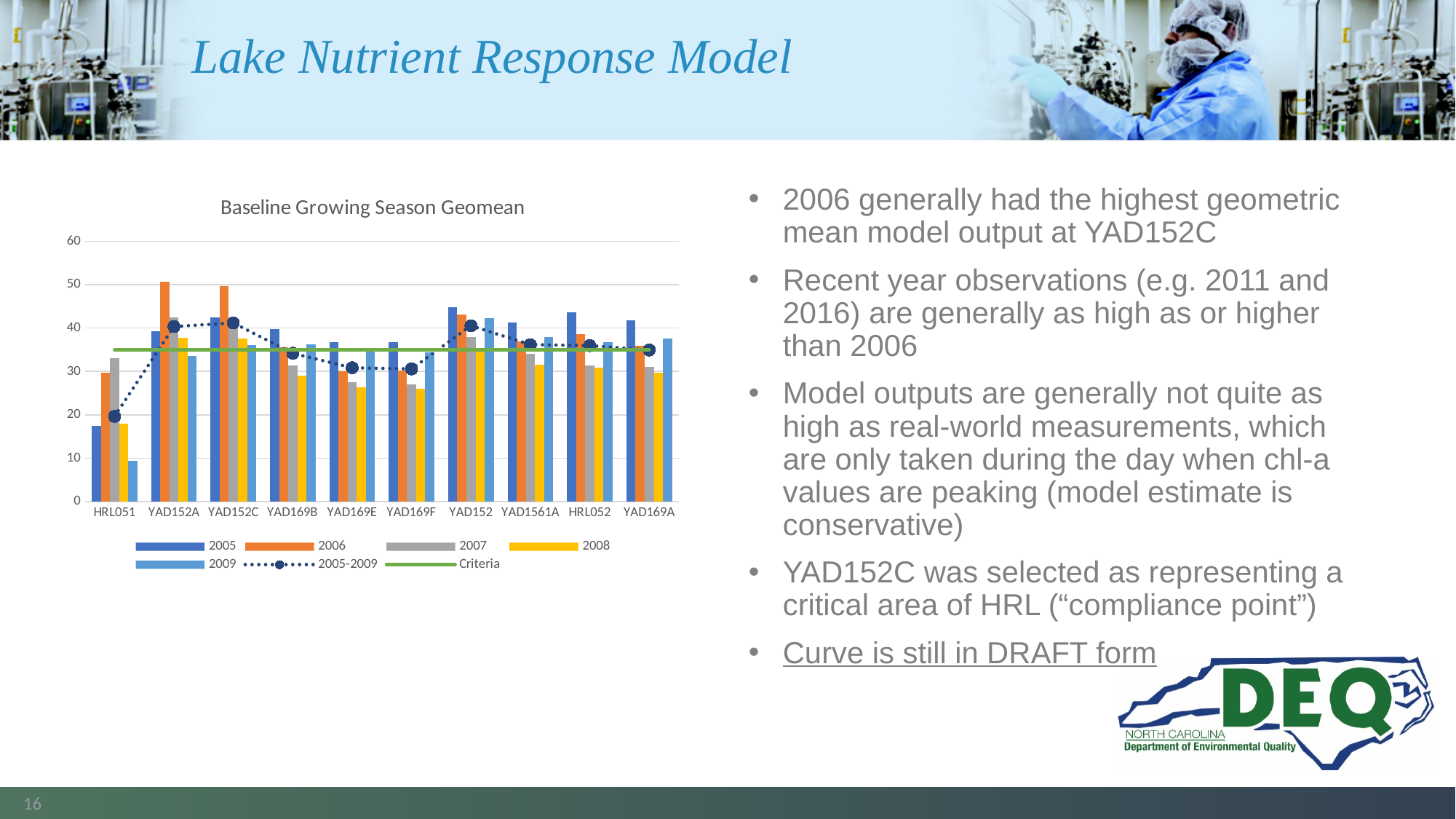
Which category has the lowest 2005 bar? HRL051 Is the 2005 value for HRL051 greater or less than 20? less At YAD169E, which is larger: the 2005 value or the 2008 value? 2005 How many entries does the chart's legend list? 7 What is the title of the chart? Baseline Growing Season Geomean Which category has the lowest 2009 bar? HRL051 At HRL051, which is larger: the 2005 value or the 2006 value? 2006 Is the 2005 value for HRL052 greater or less than 40? greater Is the 2006 value for YAD152A greater or less than 40? greater What kind of chart is shown on the slide? combination bar and line chart How many categories (monitoring stations) are shown on the x axis of the chart? 10